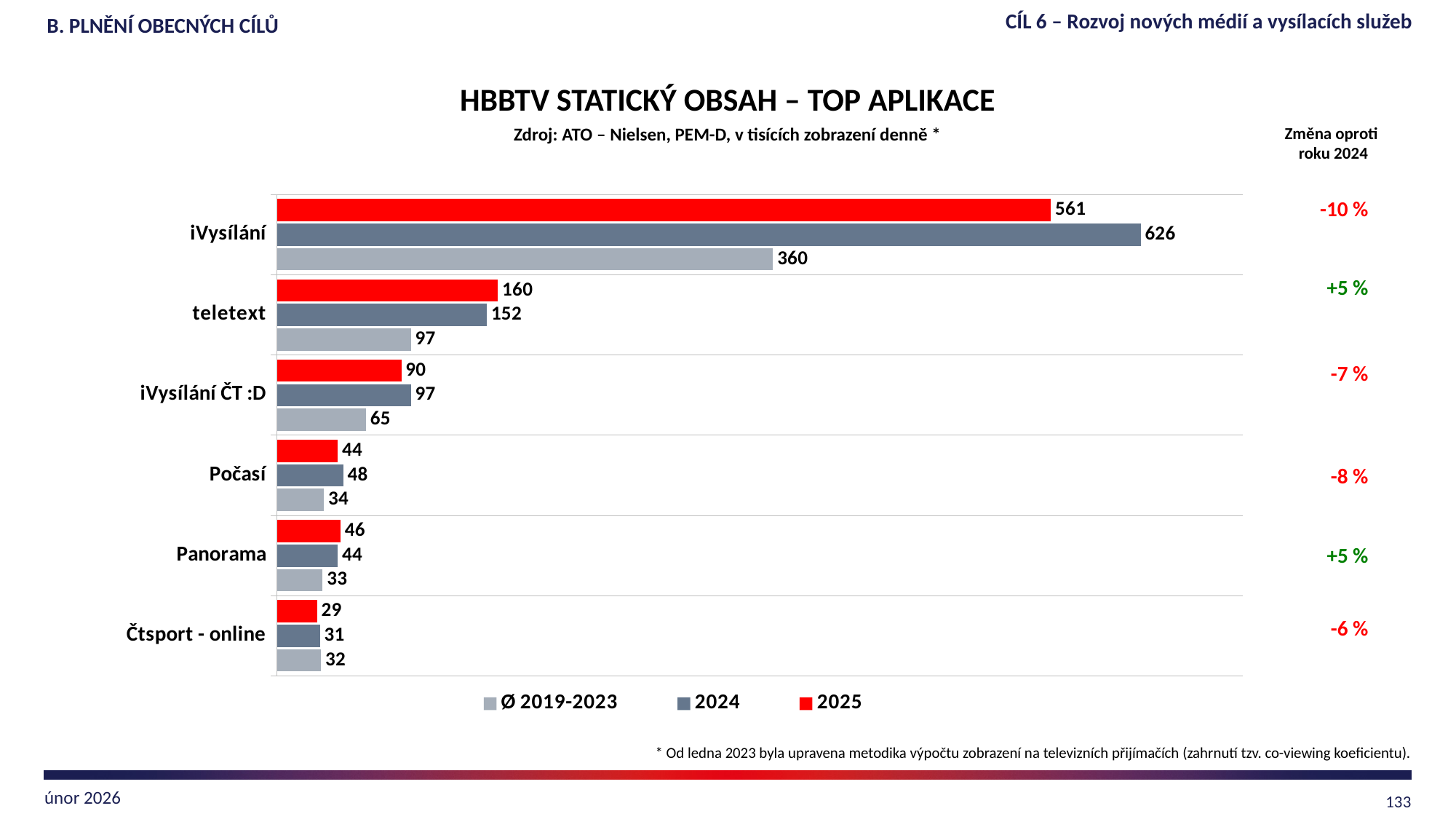
Which colour represents the 2025 series in the legend? red What kind of chart is shown on the slide? bar chart What is the 2025 value for iVysílání? 561 What is the difference between the 2025 and Ø 2019-2023 values for teletext? 63 What is the 2024 value for teletext? 152 How many series does the legend list? 3 Which is larger for Panorama: the 2024 value or the 2025 value? 2025 What is the Ø 2019-2023 value for Počasí? 34 What is the difference between the 2024 and 2025 values for iVysílání? 65 Which category has the lowest 2025 value? Čtsport - online Which category has the highest 2024 value? iVysílání How many categories are shown on the chart? 6